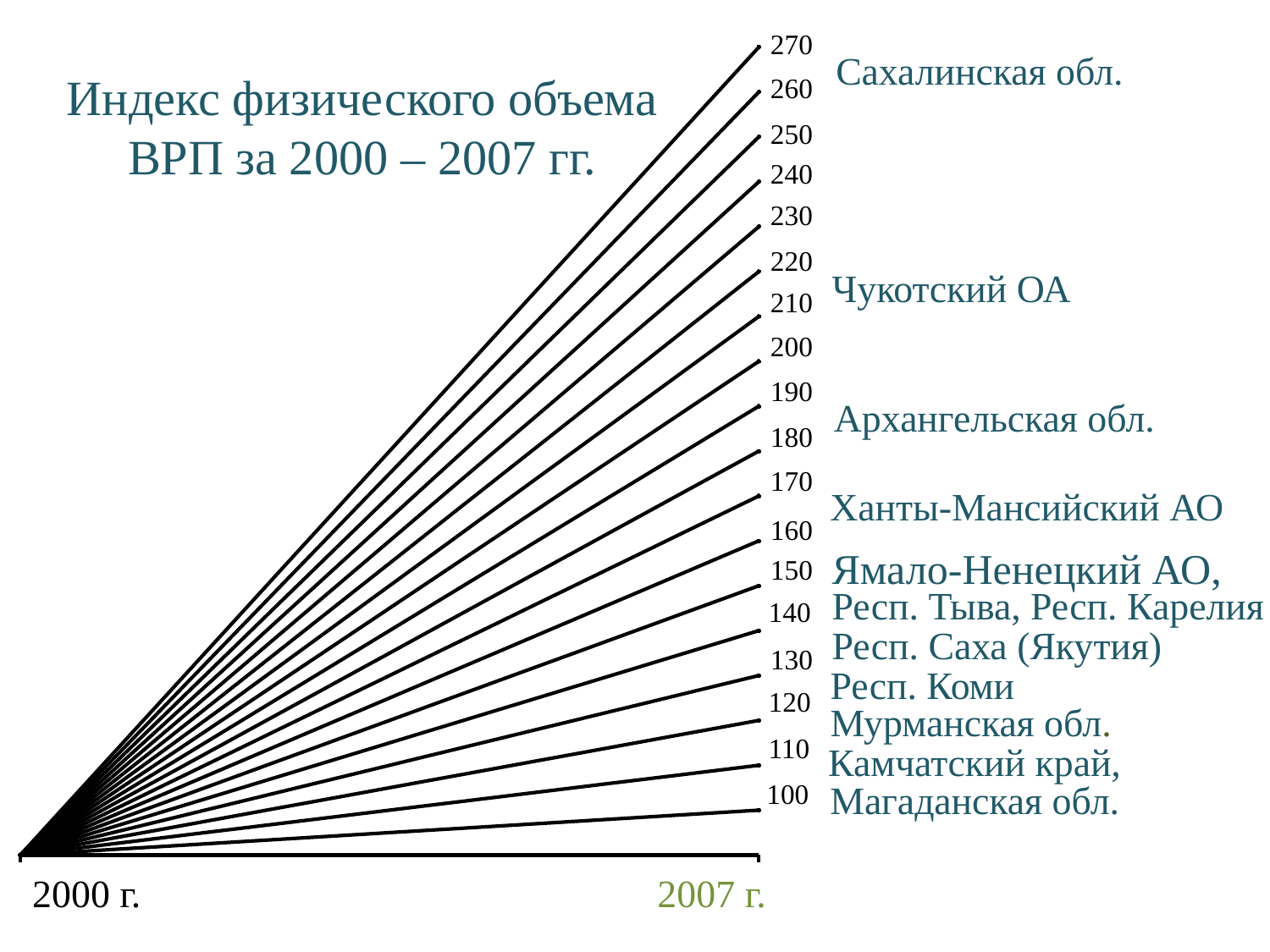
Is the 2007 value for Мурманская обл. greater or less than 150? less What kind of chart is shown on the slide? line chart Which has the larger 2007 value, Сахалинская обл. or Магаданская обл.? Сахалинская обл. Do the lines rise or fall from 2000 to 2007? rise Is the 2007 value for Сахалинская обл. greater or less than 200? greater What two years are labelled on the horizontal axis? 2000 г. and 2007 г. Which region has the highest index value in 2007? Сахалинская обл. Is the 2007 value for Ханты-Мансийский АО greater or less than 150? greater What is the title of the chart? Индекс физического объема ВРП за 2000 – 2007 гг. Which has the larger 2007 value, Чукотский ОА or Архангельская обл.? Чукотский ОА